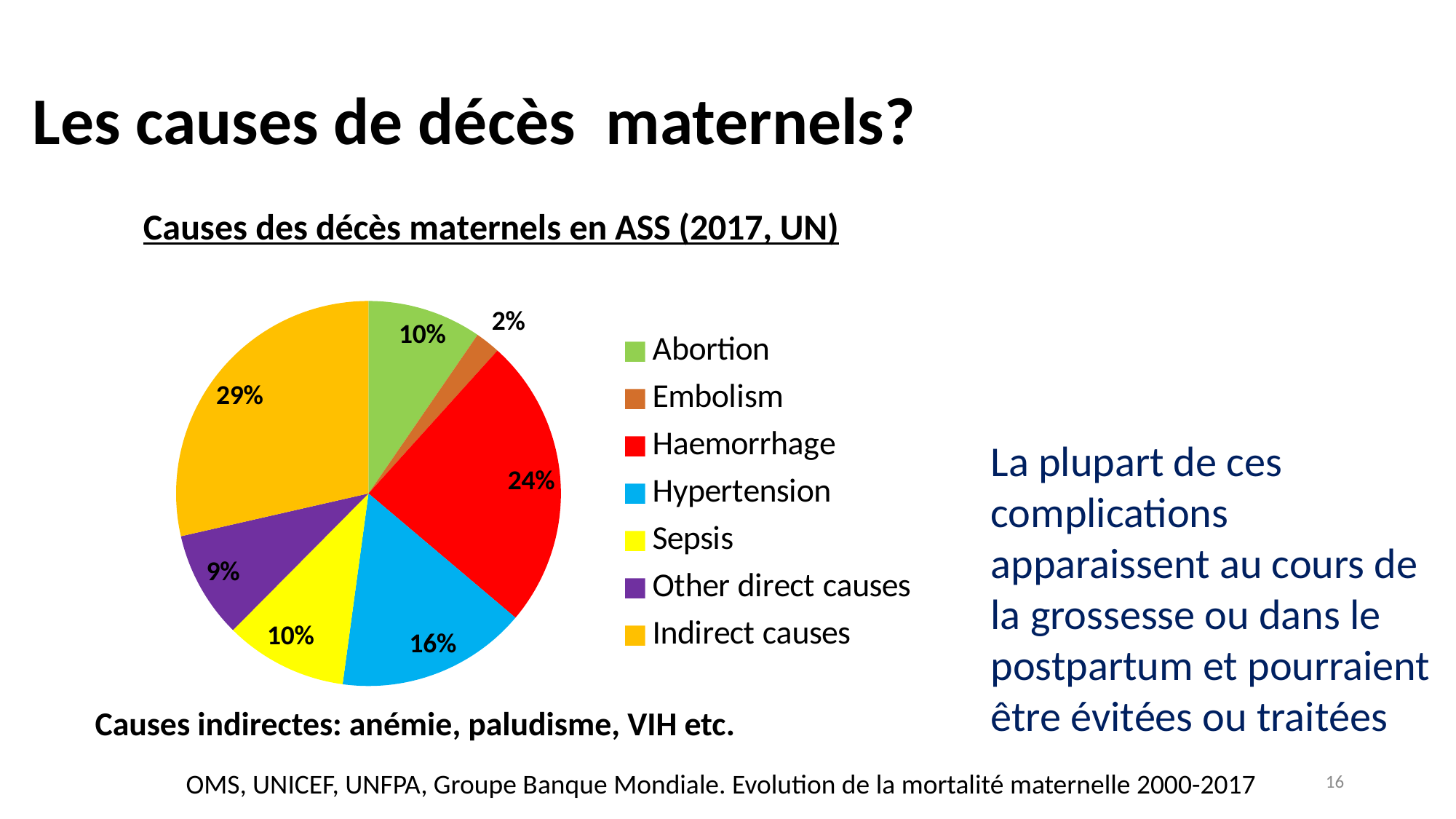
Which is larger, the share for Sepsis or the share for Other direct causes? Sepsis What share of the pie does Indirect causes represent? 29% Which cause has the smallest slice of the pie? Embolism What share of the pie does Haemorrhage represent? 24% What is the value shown for Embolism? 2% What is the difference between the Haemorrhage and Hypertension shares? 8% What is the value shown for Other direct causes? 9% Which cause has the largest slice of the pie? Indirect causes What colour is the Sepsis slice? Yellow What is the value shown for Hypertension? 16% How many categories does the legend list? 7 What kind of chart is shown on the slide? Pie chart